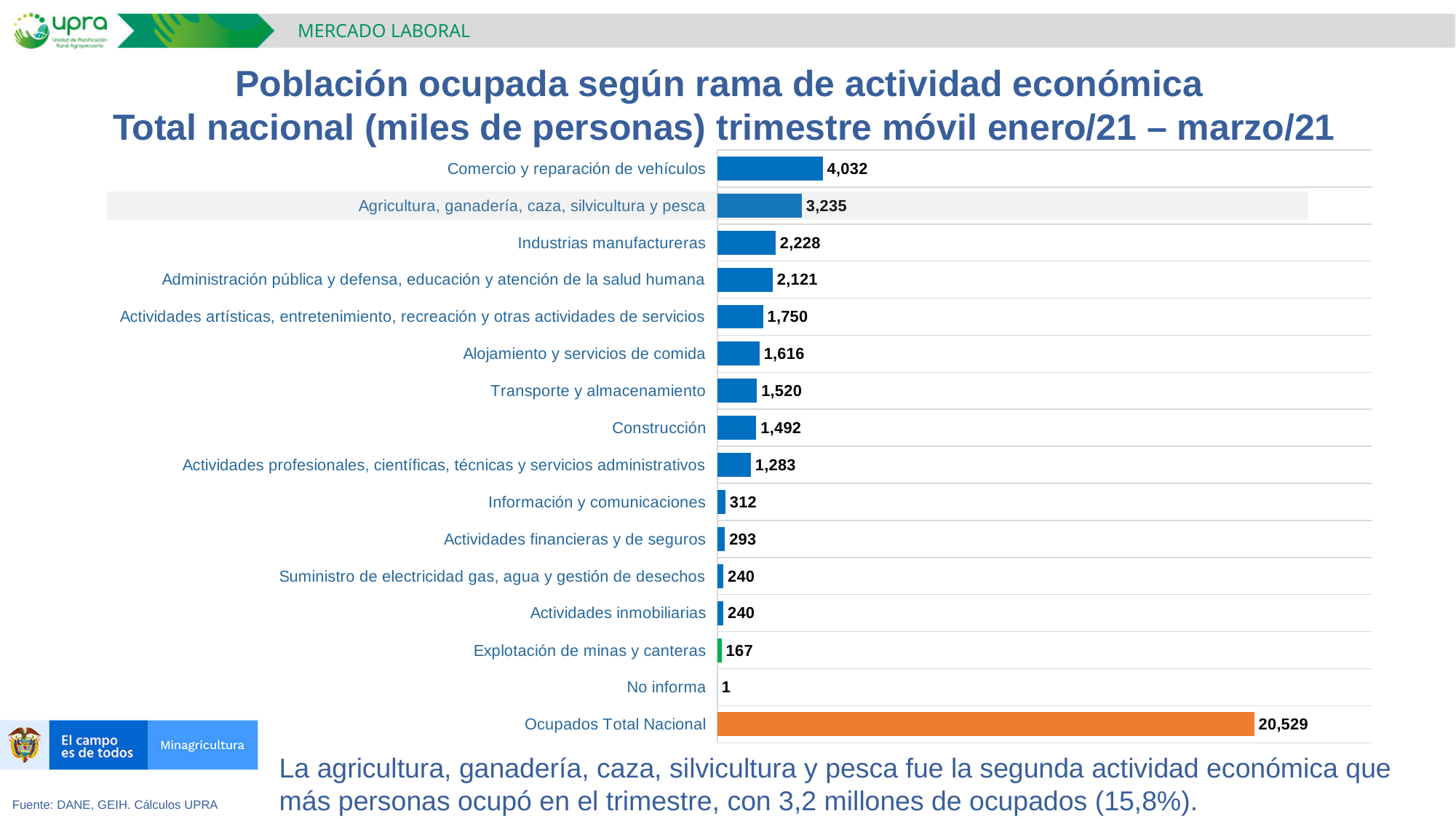
How many bars (categories) are shown in the chart? 16 Which is larger, Transporte y almacenamiento or Construcción? Transporte y almacenamiento Which category has the lowest value? No informa Excluding the Ocupados Total Nacional bar, which economic activity has the highest value? Comercio y reparación de vehículos What is the difference between Industrias manufactureras and Administración pública y defensa, educación y atención de la salud humana? 107 What is the value for Explotación de minas y canteras? 167 What is the difference between Comercio y reparación de vehículos and Agricultura, ganadería, caza, silvicultura y pesca? 797 What colour is the bar for Ocupados Total Nacional? Orange What type of chart is shown on the slide? Bar chart What is the value for Agricultura, ganadería, caza, silvicultura y pesca? 3,235 What is the value for Ocupados Total Nacional? 20,529 What is the value for Comercio y reparación de vehículos? 4,032